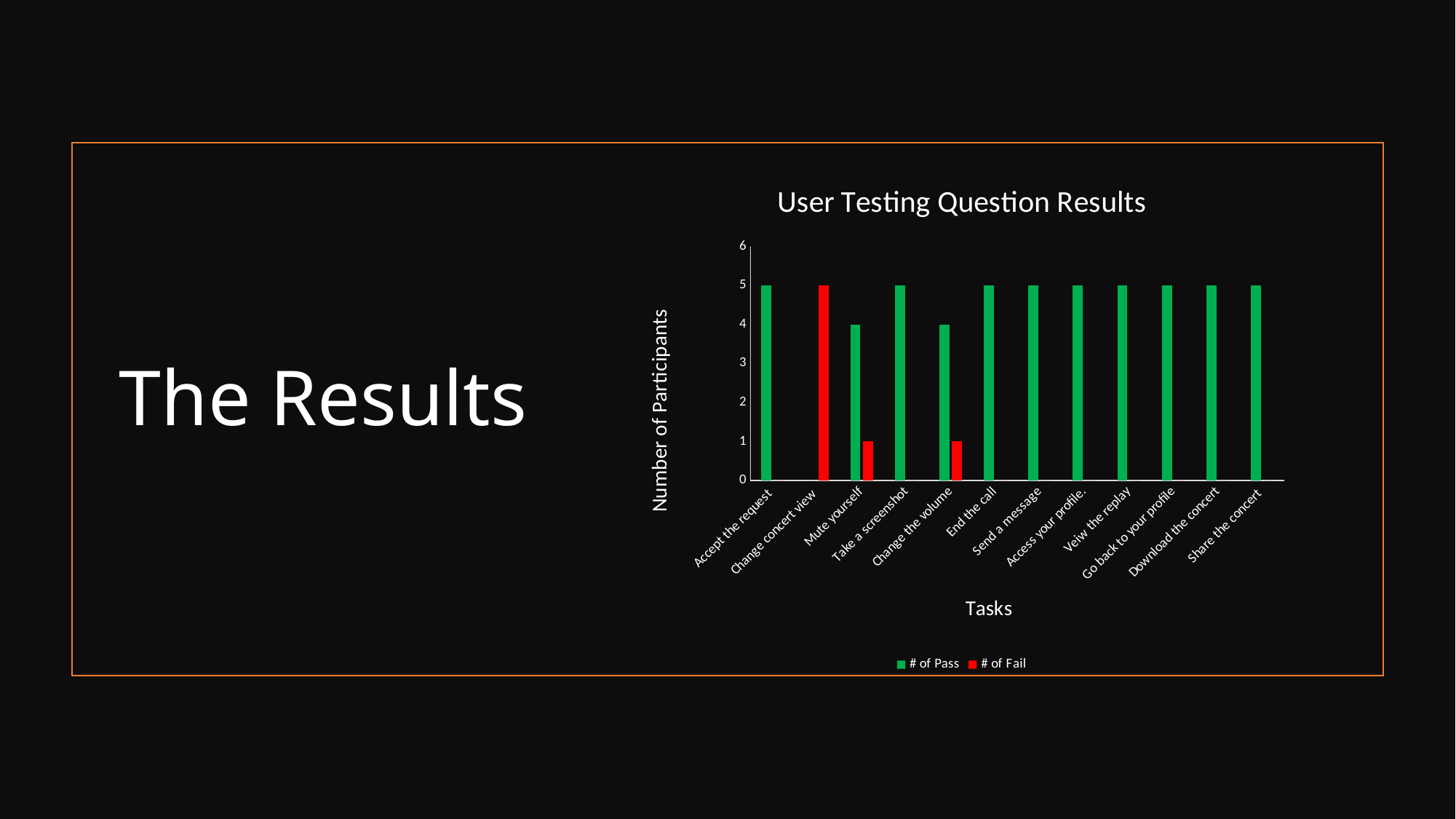
How many tasks are shown on the x axis? 12 What is the difference between the # of Pass for Accept the request and the # of Pass for Change the volume? 1 What is the label of the y axis? Number of Participants Which is larger for Mute yourself, # of Pass or # of Fail? # of Pass What type of chart is shown on the slide? bar chart Which task has the highest # of Fail? Change concert view What is the # of Pass value for Mute yourself? 4 What is the # of Fail value for Change the volume? 1 What is the title of the chart? User Testing Question Results How many series does the legend list? 2 What is the # of Fail value for Change concert view? 5 Which task has the lowest # of Pass? Change concert view